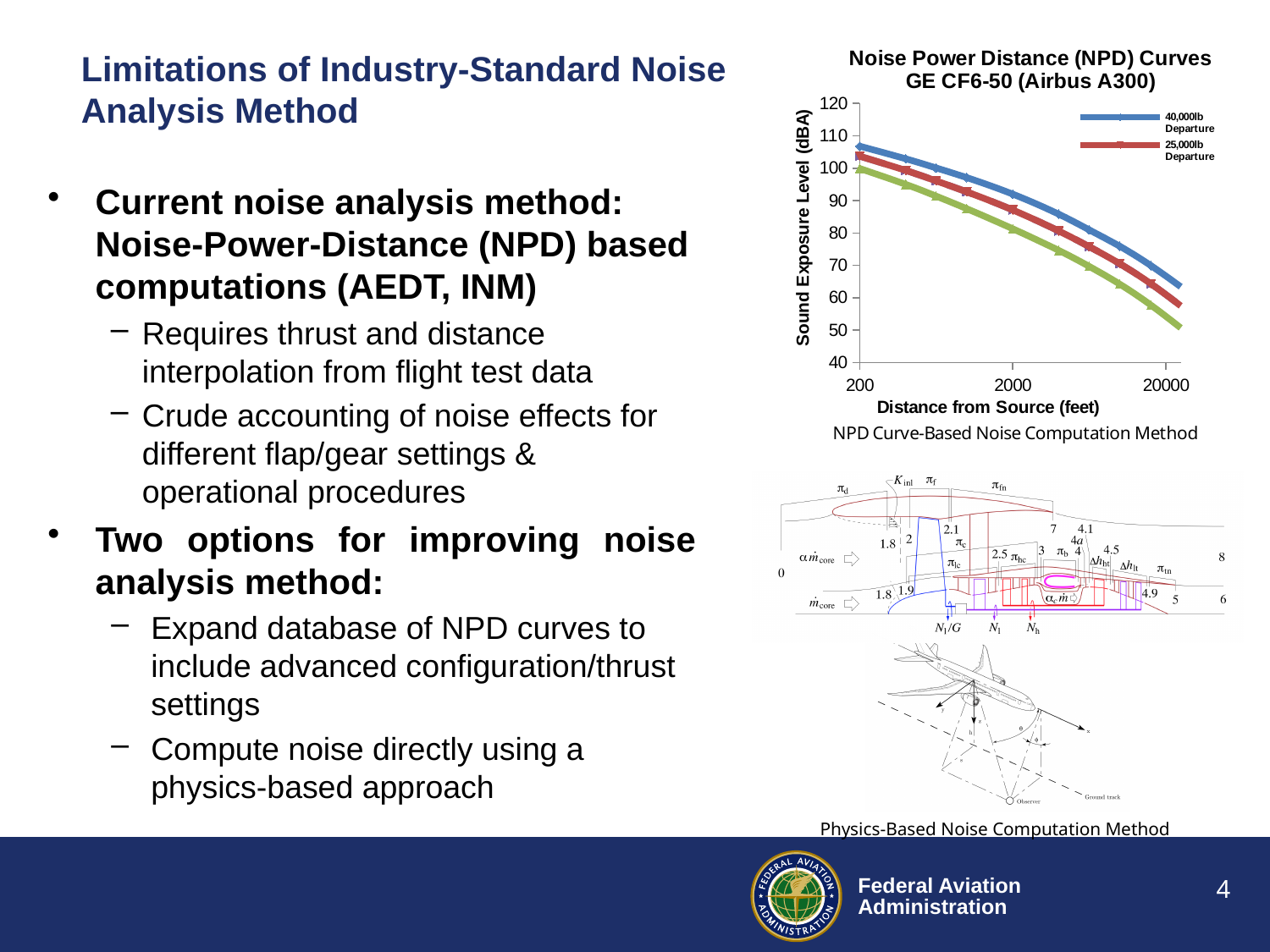
How many series does the legend of the NPD Curves chart list? 2 On the NPD Curves chart, which series has higher sound exposure levels, 40,000lb Departure or 25,000lb Departure? 40,000lb Departure On the NPD Curves chart, is the sound exposure level of the green line at 20000 feet greater or less than 60? less On the NPD Curves chart, do the sound exposure levels rise or fall as distance from the source increases? Fall What is the y-axis label of the NPD Curves chart? Sound Exposure Level (dBA) On the NPD Curves chart, is the sound exposure level for the 40,000lb Departure series at 20000 feet greater or less than 60? greater How many lines are plotted on the NPD Curves chart? 3 On the NPD Curves chart, is the sound exposure level for the 25,000lb Departure series at 2000 feet greater or less than 90? less What type of chart is the Noise Power Distance (NPD) Curves chart? Line chart Which engine and aircraft are named in the title of the NPD Curves chart? GE CF6-50 (Airbus A300)